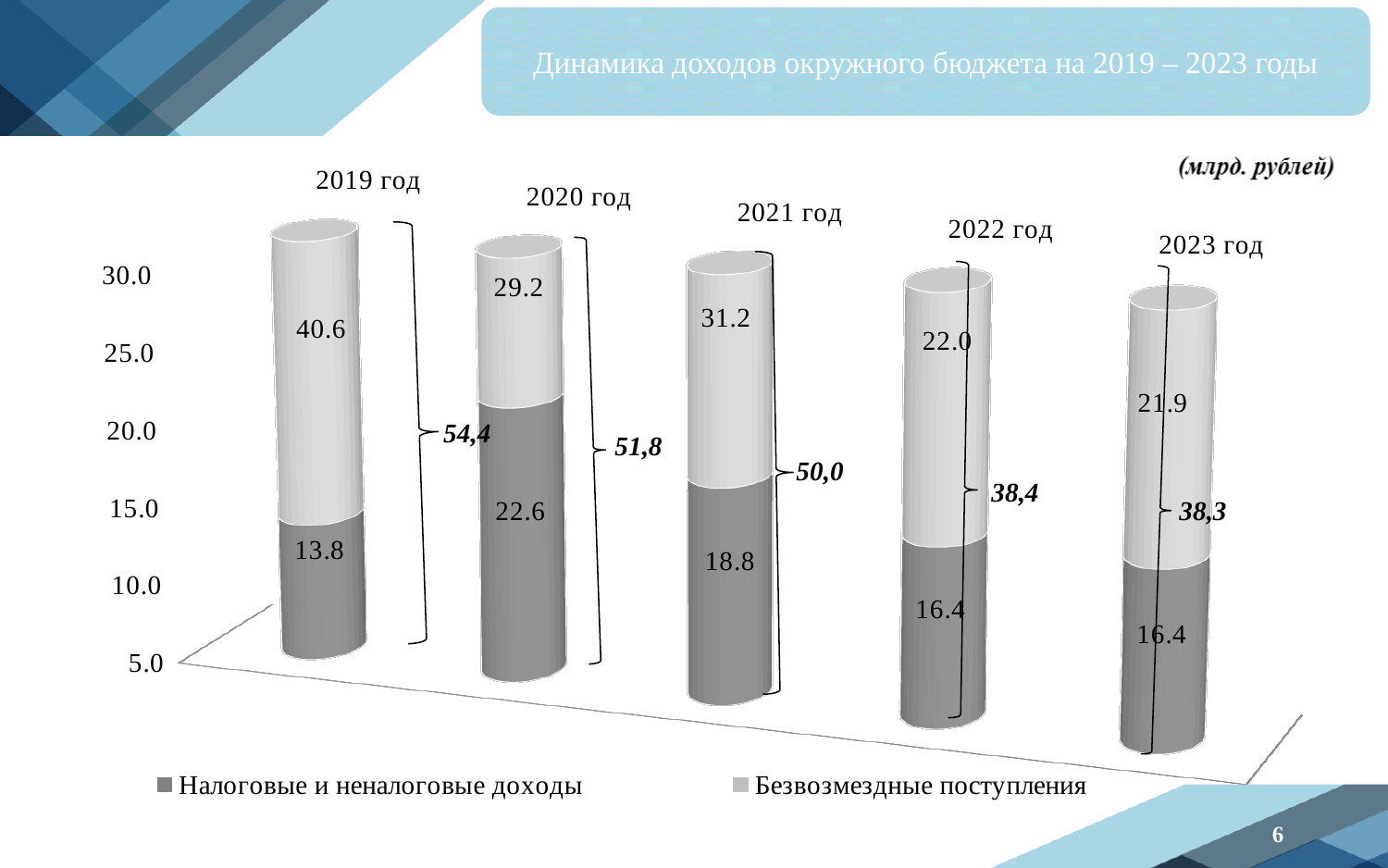
What is the value of Безвозмездные поступления for 2023 год? 21.9 What is the value of Безвозмездные поступления for 2021 год? 31.2 What is the value of Налоговые и неналоговые доходы for 2020 год? 22.6 Which year has the highest value of Безвозмездные поступления? 2019 год What is the total labelled for the 2022 год bar? 38,4 What kind of chart is shown on the slide? Stacked bar chart How many series does the legend list? 2 What is the difference between Безвозмездные поступления and Налоговые и неналоговые доходы in 2019 год? 26.8 What is the value of Налоговые и неналоговые доходы for 2019 год? 13.8 How many years are shown on the chart? 5 Which year has the lowest value of Налоговые и неналоговые доходы? 2019 год Which is larger in 2020 год: Налоговые и неналоговые доходы or Безвозмездные поступления? Безвозмездные поступления